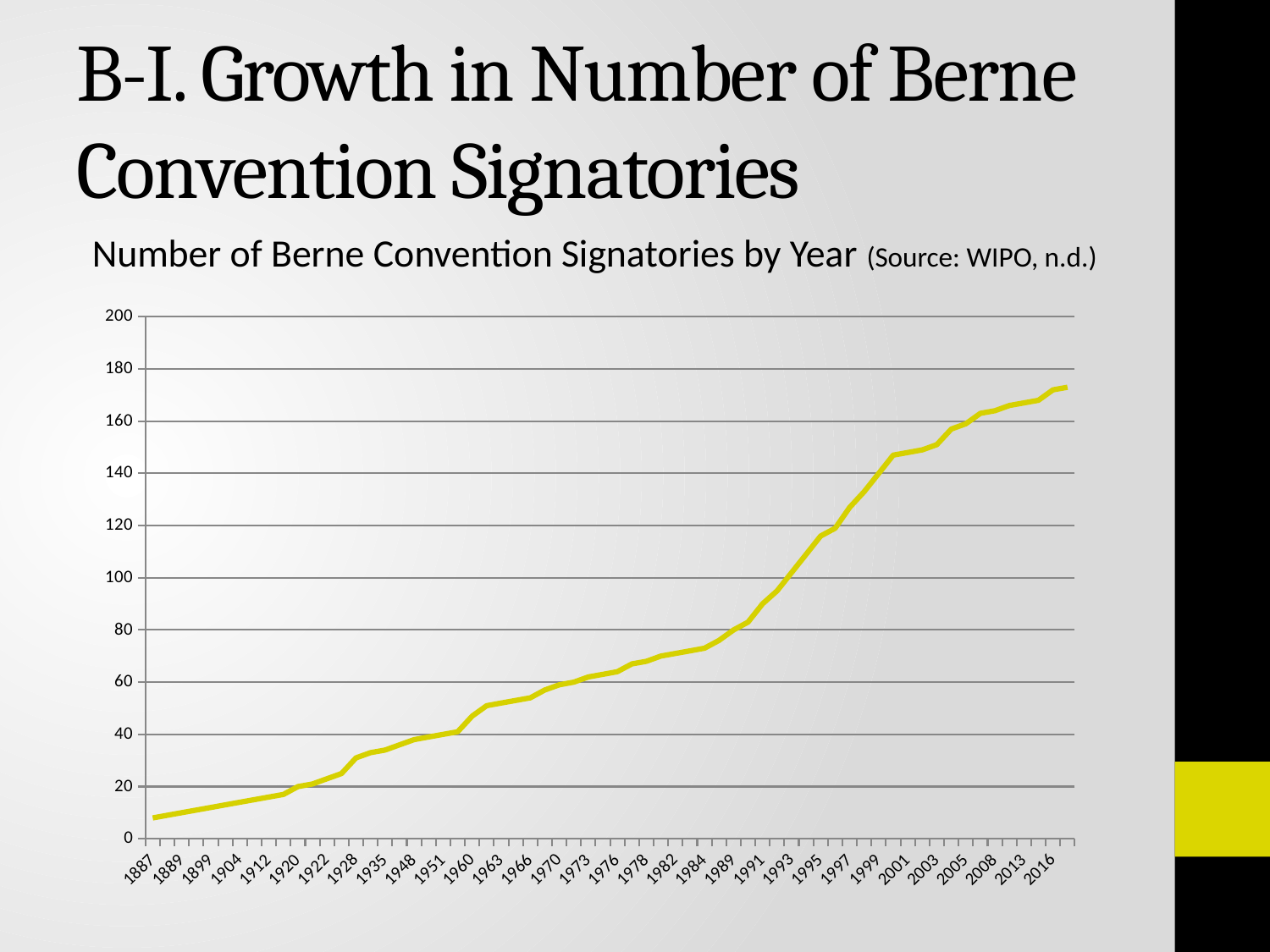
What kind of chart is shown on the slide? line chart Which year has the larger value, 1991 or 1960? 1991 Is the value for 1935 greater or less than 40? less Is the value for 2016 greater or less than 160? greater What is the title of the chart? Number of Berne Convention Signatories by Year Do the values rise or fall along the x axis from 1887 to 2016? rise Is the value for 1984 greater or less than 80? less What is the highest value shown on the y axis? 200 Which year has the lowest number of signatories? 1887